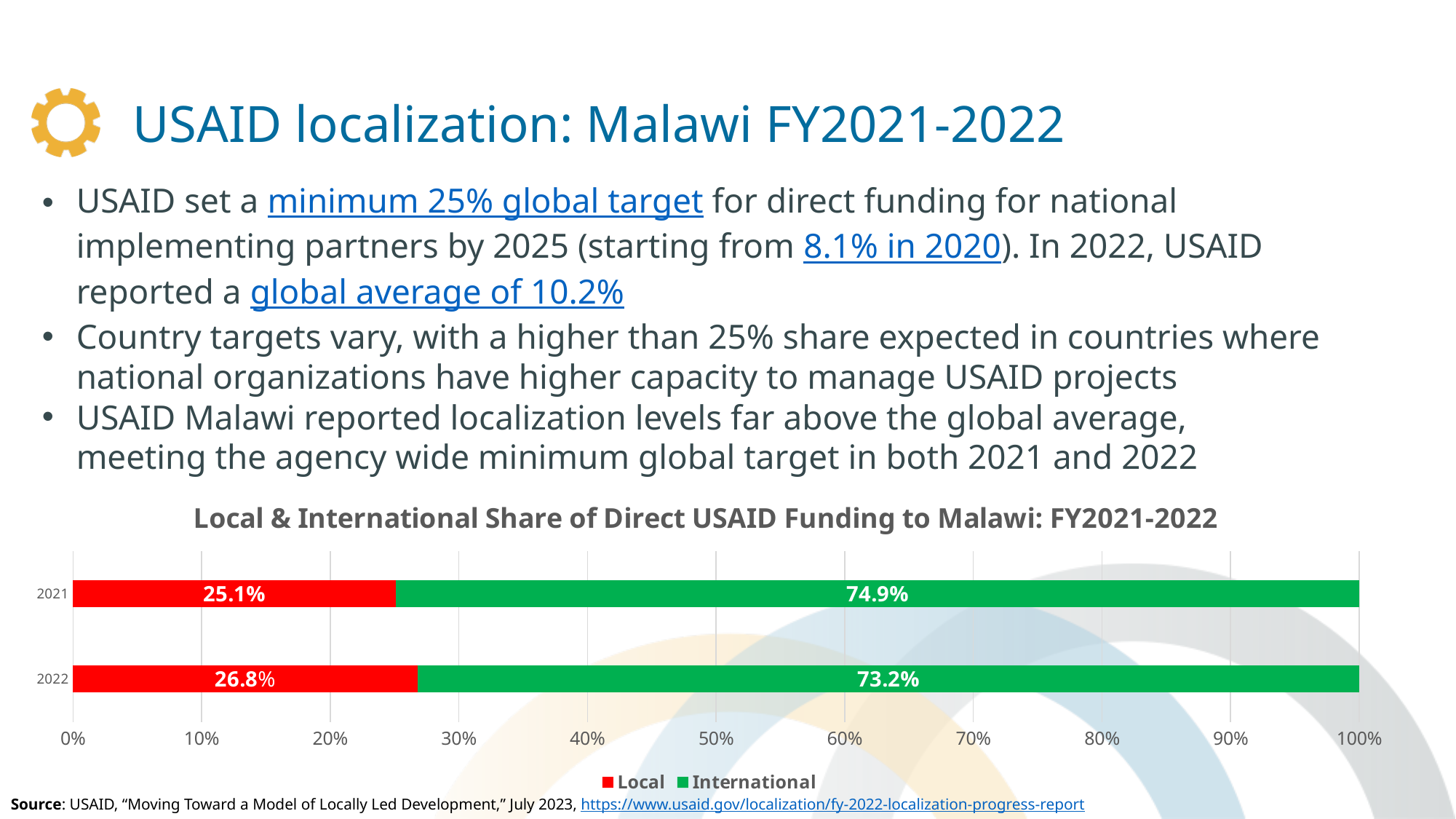
What type of chart is shown on the slide? Stacked bar chart How many years are shown on the chart? 2 Which year has the lower International share? 2022 By how many percentage points did the Local share increase from 2021 to 2022? 1.7 percentage points What is the Local share of direct USAID funding to Malawi in 2021? 25.1% What is the International share of direct USAID funding to Malawi in 2021? 74.9% What is the International share of direct USAID funding to Malawi in 2022? 73.2% How many series does the legend list? 2 What is the Local share of direct USAID funding to Malawi in 2022? 26.8% Which year has the higher Local share, 2021 or 2022? 2022 What is the difference between the International and Local shares in 2021? 49.8 percentage points What is the total of the Local and International shares for the 2022 bar? 100%